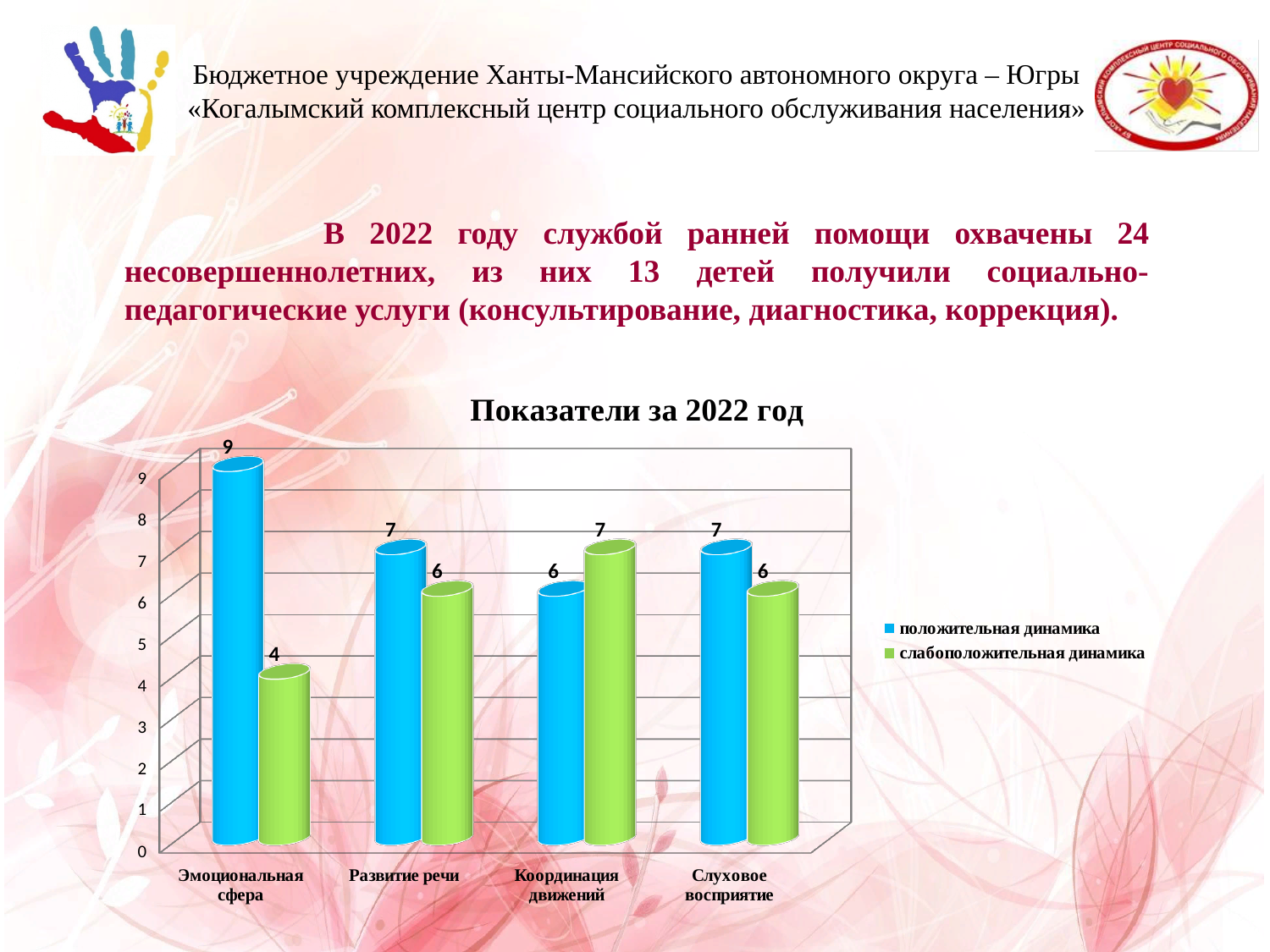
What is the value of слабоположительная динамика for Эмоциональная сфера? 4 What is the difference between положительная динамика and слабоположительная динамика for Эмоциональная сфера? 5 For Координация движений, which series has the larger value: положительная динамика or слабоположительная динамика? слабоположительная динамика What is the value of положительная динамика for Слуховое восприятие? 7 Which category has the lowest value for слабоположительная динамика? Эмоциональная сфера How many categories are shown on the x axis? 4 What kind of chart is shown on the slide? bar chart What is the title of the chart? Показатели за 2022 год What is the value of положительная динамика for Эмоциональная сфера? 9 Which category has the highest value for положительная динамика? Эмоциональная сфера How many series does the legend list? 2 What is the value of слабоположительная динамика for Координация движений? 7